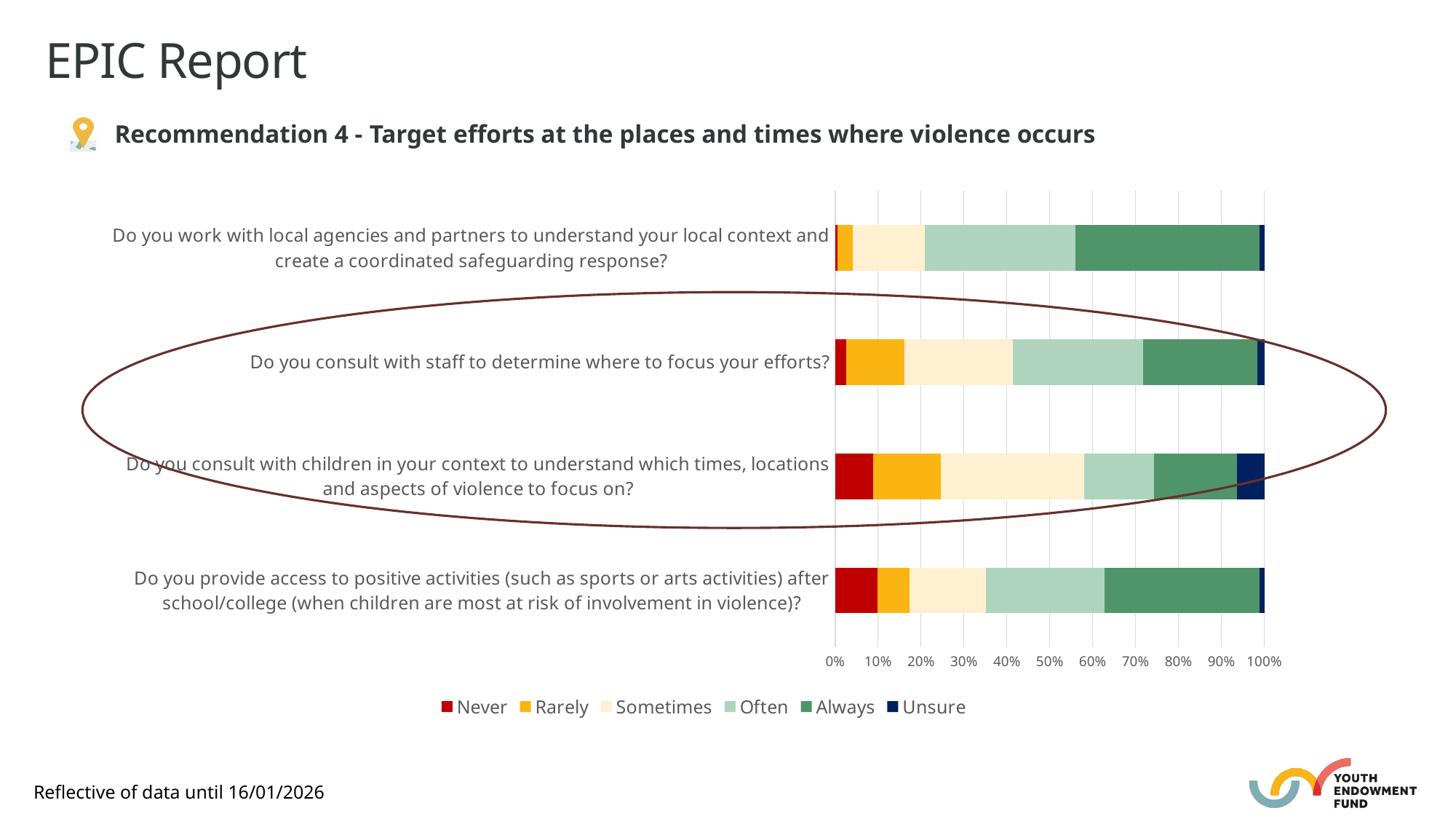
Is the 'Never' share for the question about consulting with children greater or less than 20%? less What kind of chart is shown on the slide? Stacked bar chart Which survey question has the largest 'Unsure' share? Do you consult with children in your context to understand which times, locations and aspects of violence to focus on? What value does each full stacked bar reach on the x axis? 100% Is the 'Always' share for the question about working with local agencies and partners greater or less than 30%? greater How many survey questions (categories) are plotted in the chart? 4 Is the 'Rarely' share larger for the question about consulting with staff or for the question about working with local agencies and partners? Do you consult with staff to determine where to focus your efforts? How many series does the chart legend list? 6 Which survey question has the smallest 'Never' share? Do you work with local agencies and partners to understand your local context and create a coordinated safeguarding response? What are the legend entries of the chart, in order? Never, Rarely, Sometimes, Often, Always, Unsure Which survey question has the largest 'Always' share? Do you work with local agencies and partners to understand your local context and create a coordinated safeguarding response? Which response category is shown in dark red in the chart? Never